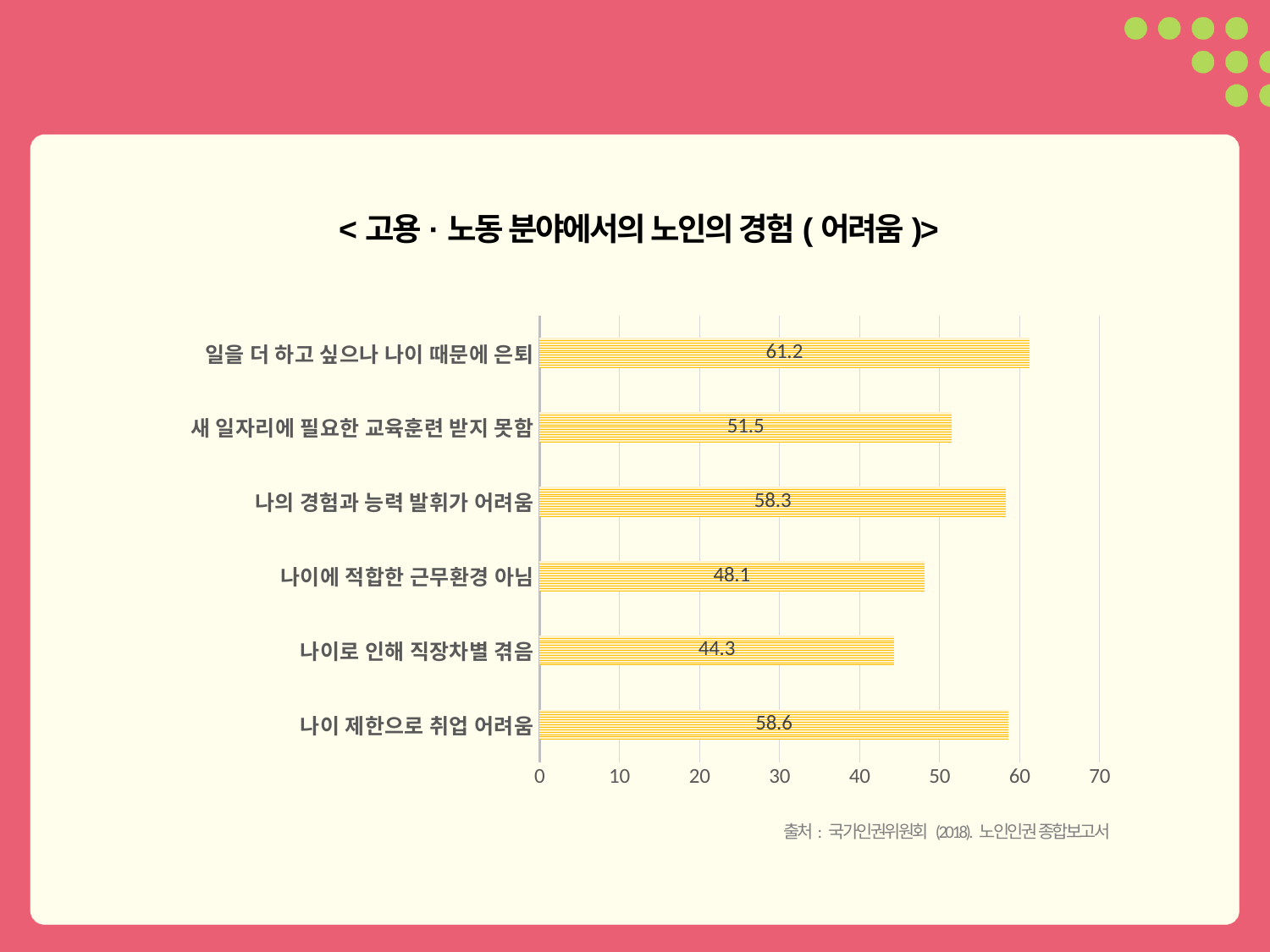
What is the value for '나이로 인해 직장차별 겪음'? 44.3 How many categories are shown in the chart? 6 Which category has the highest value? 일을 더 하고 싶으나 나이 때문에 은퇴 What is the title of the chart? < 고용 · 노동 분야에서의 노인의 경험 ( 어려움 )> What is the value for '나이에 적합한 근무환경 아님'? 48.1 What is the difference between the values for '일을 더 하고 싶으나 나이 때문에 은퇴' and '나이로 인해 직장차별 겪음'? 16.9 What is the value for '일을 더 하고 싶으나 나이 때문에 은퇴'? 61.2 Which category has the lowest value? 나이로 인해 직장차별 겪음 What is the difference between the values for '새 일자리에 필요한 교육훈련 받지 못함' and '나이에 적합한 근무환경 아님'? 3.4 What kind of chart is shown on the slide? bar chart Is the value for '나의 경험과 능력 발휘가 어려움' greater or less than 50? greater Which is larger: the value for '나이 제한으로 취업 어려움' or the value for '새 일자리에 필요한 교육훈련 받지 못함'? 나이 제한으로 취업 어려움